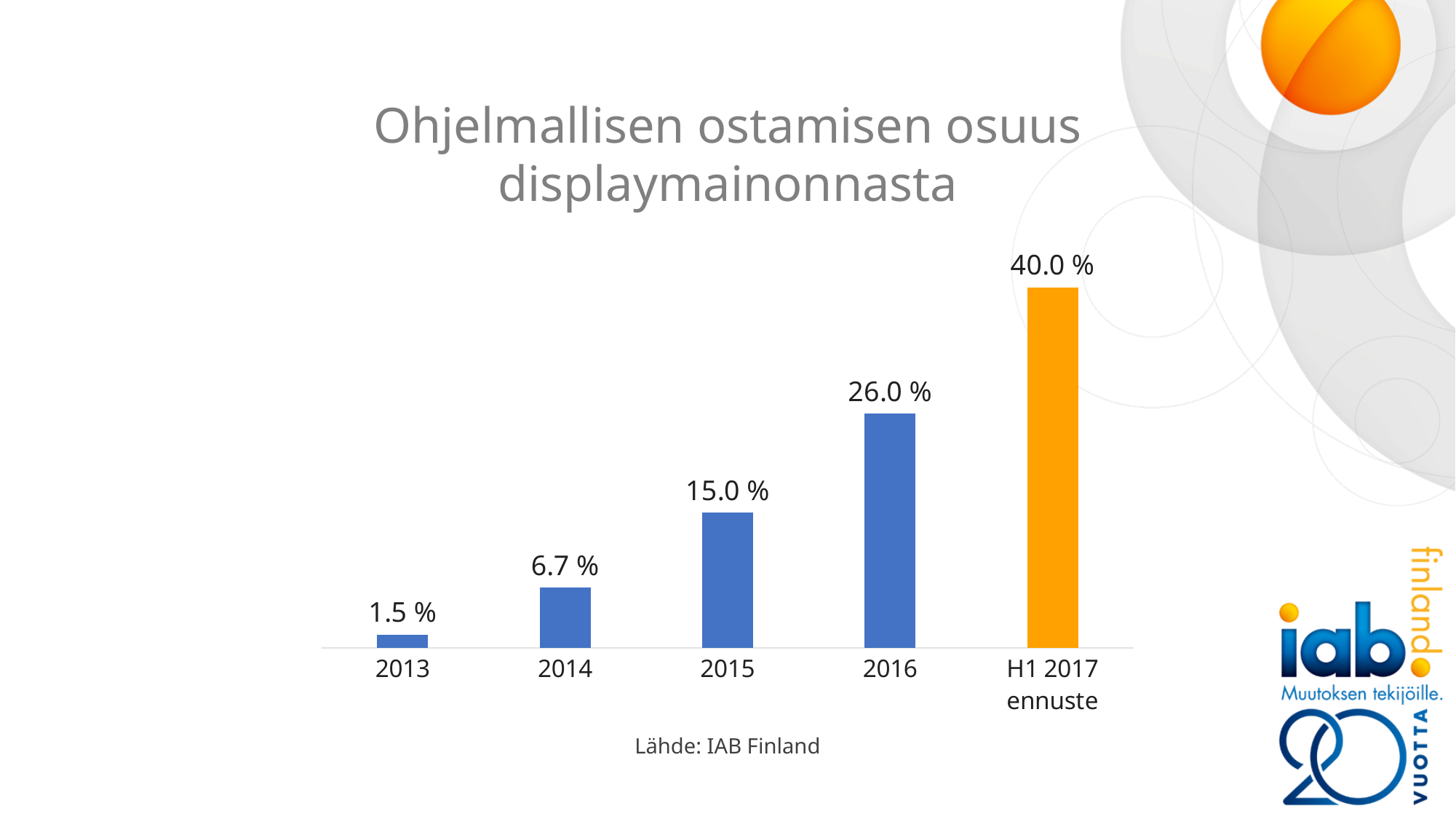
Do the values rise or fall from 2013 to H1 2017 ennuste? rise What kind of chart is shown on the slide? bar chart What is the value for 2015? 15.0 % What is the difference between the values for H1 2017 ennuste and 2016? 14.0 % Which category has the highest value? H1 2017 ennuste Which is larger, the value for 2014 or the value for 2015? 2015 What is the value for 2013? 1.5 % What is the title of the chart? Ohjelmallisen ostamisen osuus displaymainonnasta What is the value for H1 2017 ennuste? 40.0 % What is the difference between the values for 2016 and 2015? 11.0 % Which category has the lowest value? 2013 How many categories are shown on the x axis? 5